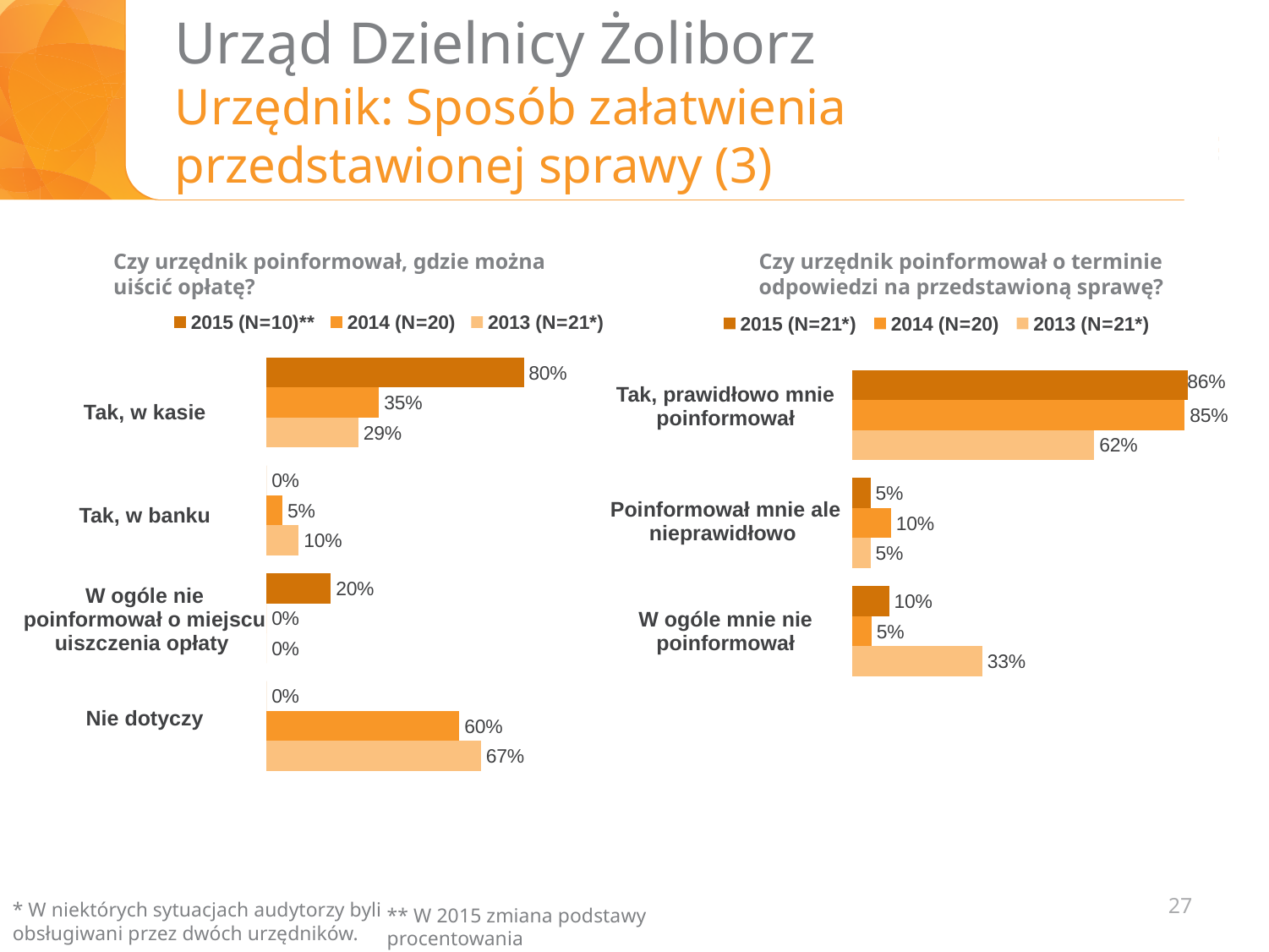
In the right chart (Czy urzędnik poinformował o terminie odpowiedzi na przedstawioną sprawę?), which is larger for 'Poinformował mnie ale nieprawidłowo': the 2014 value or the 2015 value? 2014 In the right chart (Czy urzędnik poinformował o terminie odpowiedzi na przedstawioną sprawę?), what is the legend label of the first series? 2015 (N=21*) In the left chart (Czy urzędnik poinformował, gdzie można uiścić opłatę?), which category has the highest value in the 2014 series? Nie dotyczy In the right chart (Czy urzędnik poinformował o terminie odpowiedzi na przedstawioną sprawę?), what is the value for 'Tak, prawidłowo mnie poinformował' in the 2013 series? 62% What kind of chart is the right chart (Czy urzędnik poinformował o terminie odpowiedzi na przedstawioną sprawę?)? Bar chart In the left chart (Czy urzędnik poinformował, gdzie można uiścić opłatę?), what is the value for 'Nie dotyczy' in the 2013 series? 67% In the right chart (Czy urzędnik poinformował o terminie odpowiedzi na przedstawioną sprawę?), what is the difference between the 2013 and 2014 values for 'W ogóle mnie nie poinformował'? 28% In the left chart (Czy urzędnik poinformował, gdzie można uiścić opłatę?), how many series does the legend list? 3 In the left chart (Czy urzędnik poinformował, gdzie można uiścić opłatę?), what is the value for 'Tak, w kasie' in the 2015 series? 80% In the right chart (Czy urzędnik poinformował o terminie odpowiedzi na przedstawioną sprawę?), what is the value for 'W ogóle mnie nie poinformował' in the 2013 series? 33% In the left chart (Czy urzędnik poinformował, gdzie można uiścić opłatę?), how many categories are shown? 4 In the left chart (Czy urzędnik poinformował, gdzie można uiścić opłatę?), what is the difference between the 2015 and 2014 values for 'Tak, w kasie'? 45%